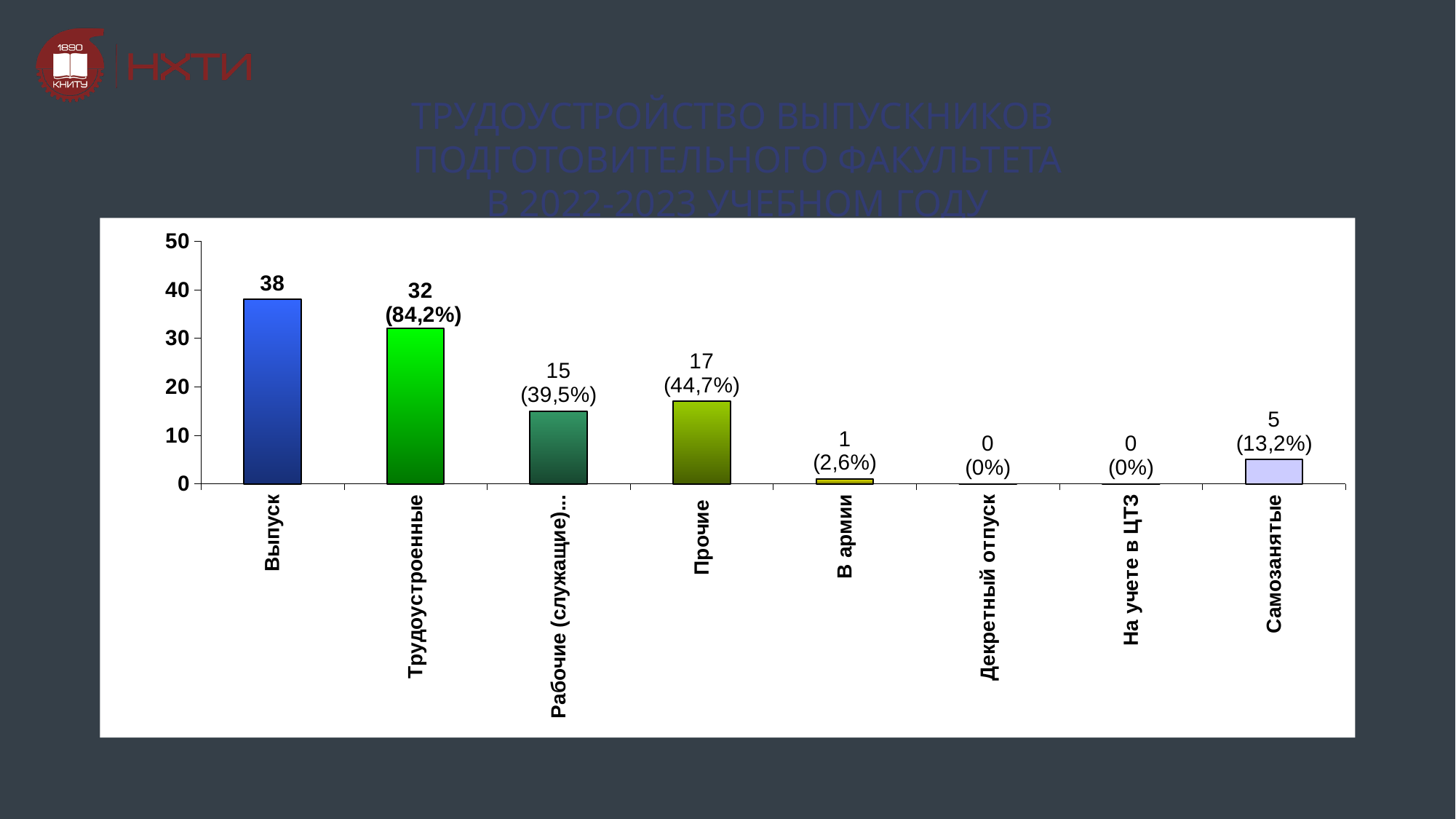
What is the value for Выпуск? 38 What kind of chart is shown on the slide? bar chart What is the value for Трудоустроенные? 32 What is the value for Прочие? 17 What percentage is shown for Самозанятые? 13,2% How many categories have a value of 0? 2 Which is larger, the value for Прочие or the value for Рабочие (служащие)? Прочие Is the value for Трудоустроенные greater or less than 30? greater What is the difference between the values for Выпуск and Трудоустроенные? 6 Which category has the highest value? Выпуск How many categories are shown on the x axis? 8 What percentage is shown for Трудоустроенные? 84,2%